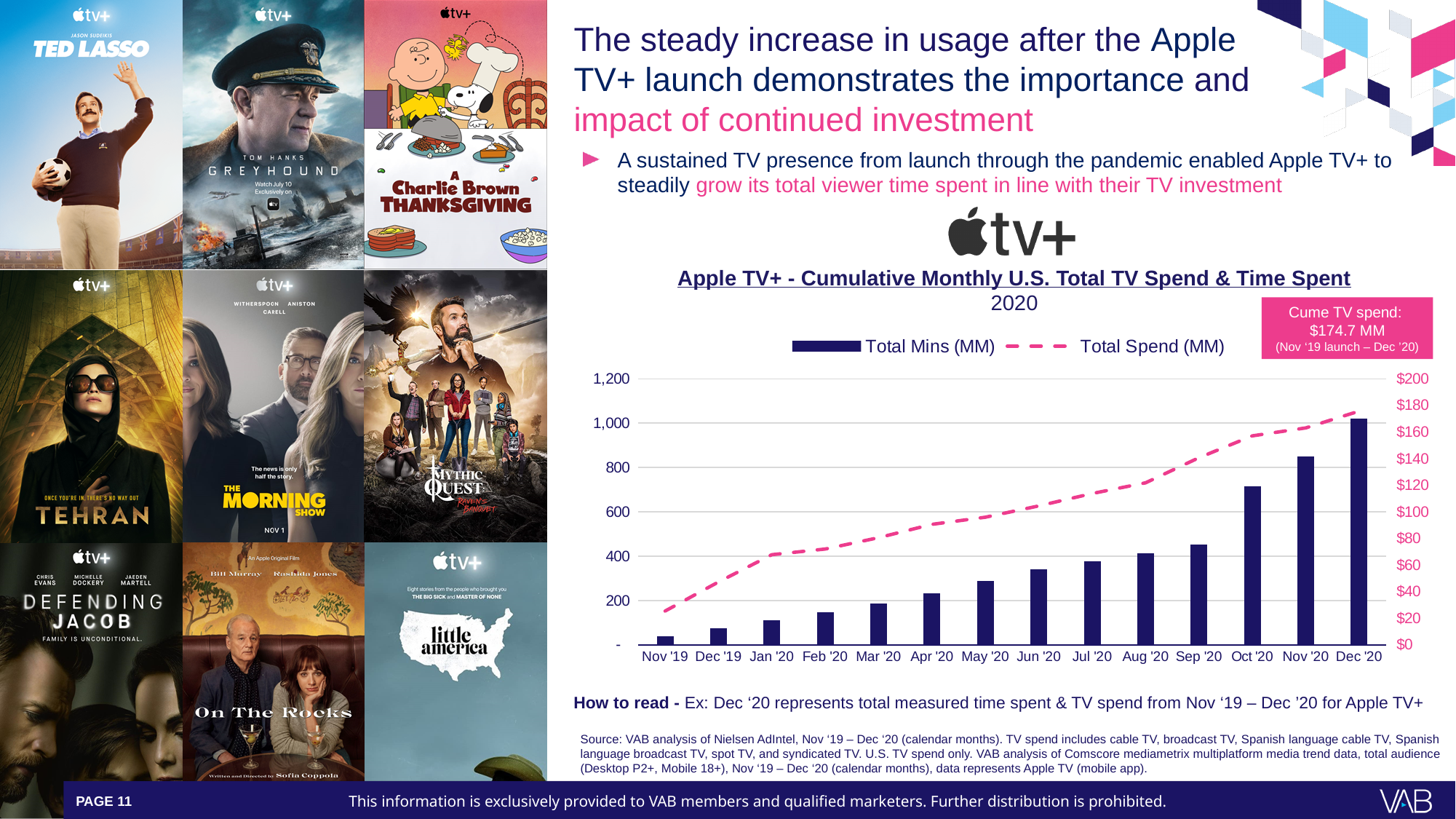
Is the Total Mins (MM) value for Nov '20 greater or less than 800? greater Is the Total Mins (MM) value for Jun '20 greater or less than 400? less Do the Total Mins (MM) bars rise or fall from Nov '19 to Dec '20? Rise Is the Total Mins (MM) value for Feb '20 greater or less than 200? less How many months are shown along the x axis of the chart? 14 Which month has the highest Total Mins (MM) bar? Dec '20 Which month has the larger Total Mins (MM) bar, Sep '20 or Oct '20? Oct '20 What cumulative TV spend figure is shown in the callout box on the chart? $174.7 MM What kind of chart is shown on the slide? A bar chart combined with a dashed line What is the title of the chart? Apple TV+ - Cumulative Monthly U.S. Total TV Spend & Time Spent How many series does the chart legend list? 2 Which month has the lowest Total Mins (MM) bar? Nov '19